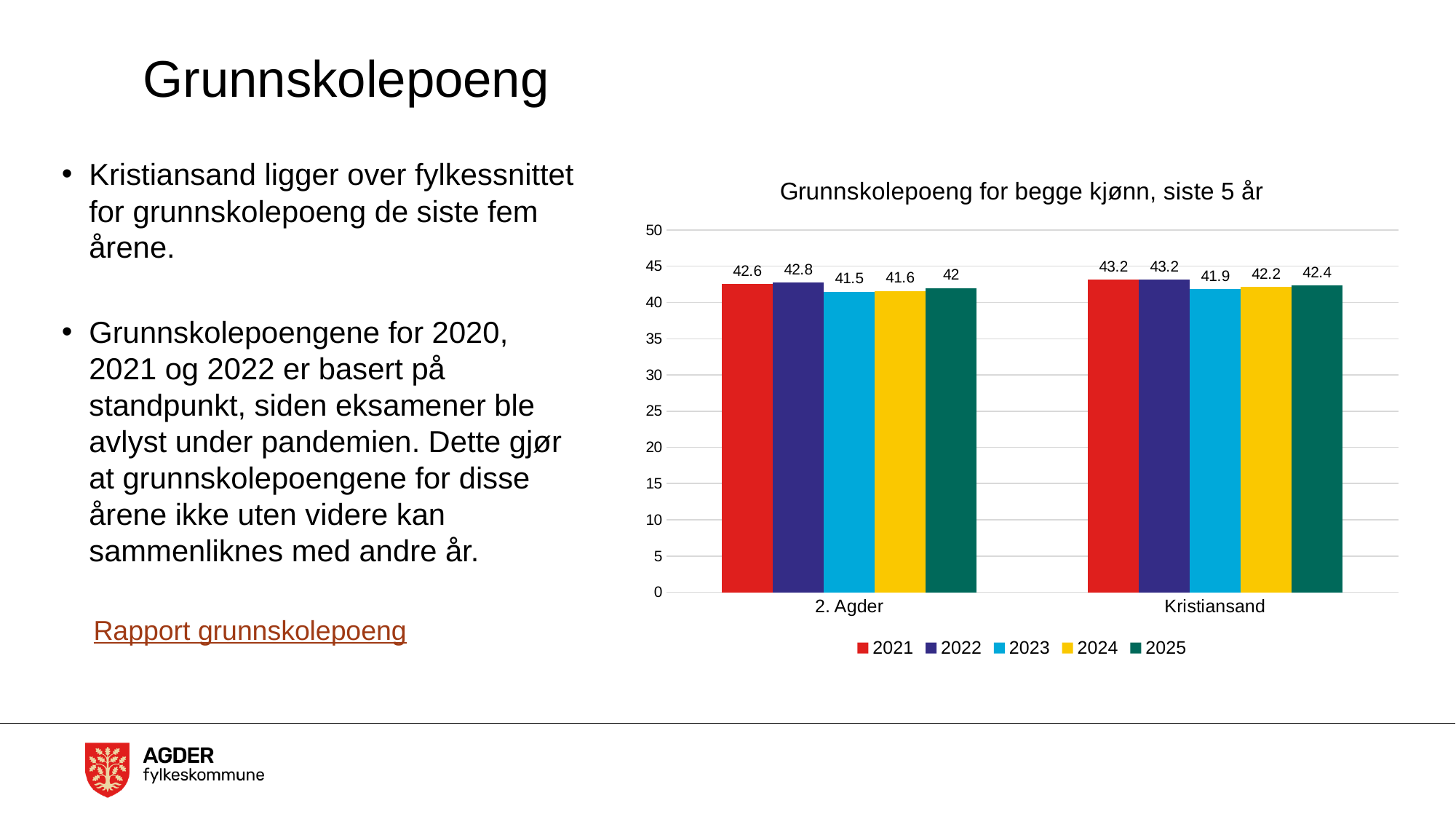
What is the difference between the Kristiansand and 2. Agder values in 2022? 0.4 What is the value for Kristiansand in 2025? 42.4 What is the value for Kristiansand in 2023? 41.9 Which year has the lowest value for 2. Agder? 2023 Which is larger, the 2024 value for Kristiansand or the 2024 value for 2. Agder? Kristiansand What is the title of the chart? Grunnskolepoeng for begge kjønn, siste 5 år What is the difference between the 2021 and 2025 values for 2. Agder? 0.6 What is the value for 2. Agder in 2021? 42.6 What kind of chart is shown on the slide? Bar chart What is the value for 2. Agder in 2024? 41.6 Is the value for Kristiansand in 2021 greater or less than 40? greater How many series does the legend list? 5